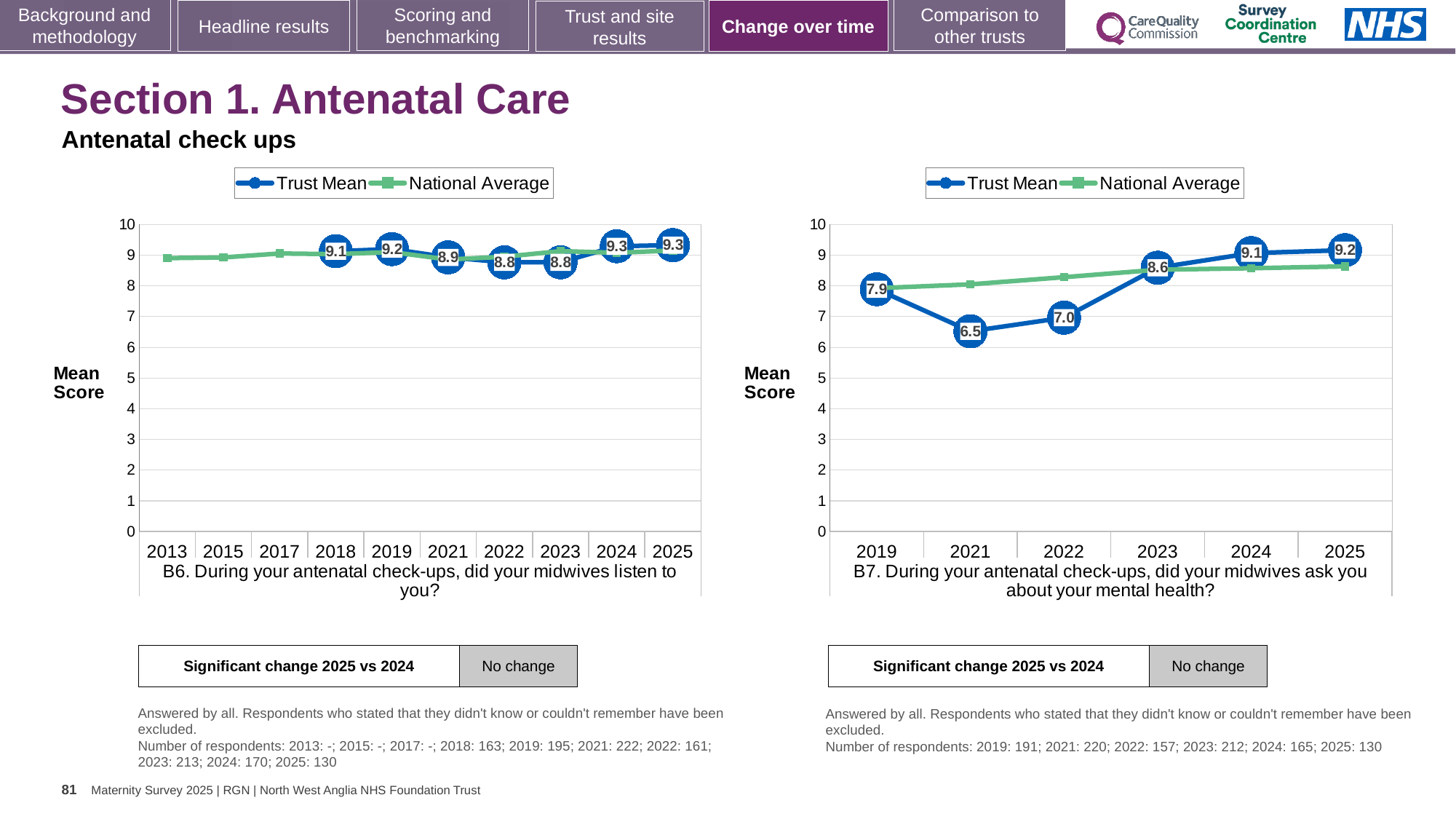
On the left chart (B6), what is the difference between the Trust Mean scores for 2024 and 2023? 0.5 On the left chart (B6), what is the Trust Mean score for 2021? 8.9 On the right chart (B7), which year has the lowest Trust Mean score? 2021 On the right chart (B7), what is the Trust Mean score for 2019? 7.9 How many years are shown on the x axis of the left chart (B6)? 10 What kind of chart is the right chart (B7)? Line chart On the left chart (B6), which is larger, the Trust Mean for 2019 or the Trust Mean for 2022? 2019 On the right chart (B7), what is the difference between the Trust Mean scores for 2025 and 2021? 2.7 On the right chart (B7), which year has the highest Trust Mean score? 2025 How many series does the legend of the right chart (B7) list? 2 On the right chart (B7), is the National Average value for 2019 greater or less than 7? greater On the left chart (B6), what is the Trust Mean score for 2025? 9.3